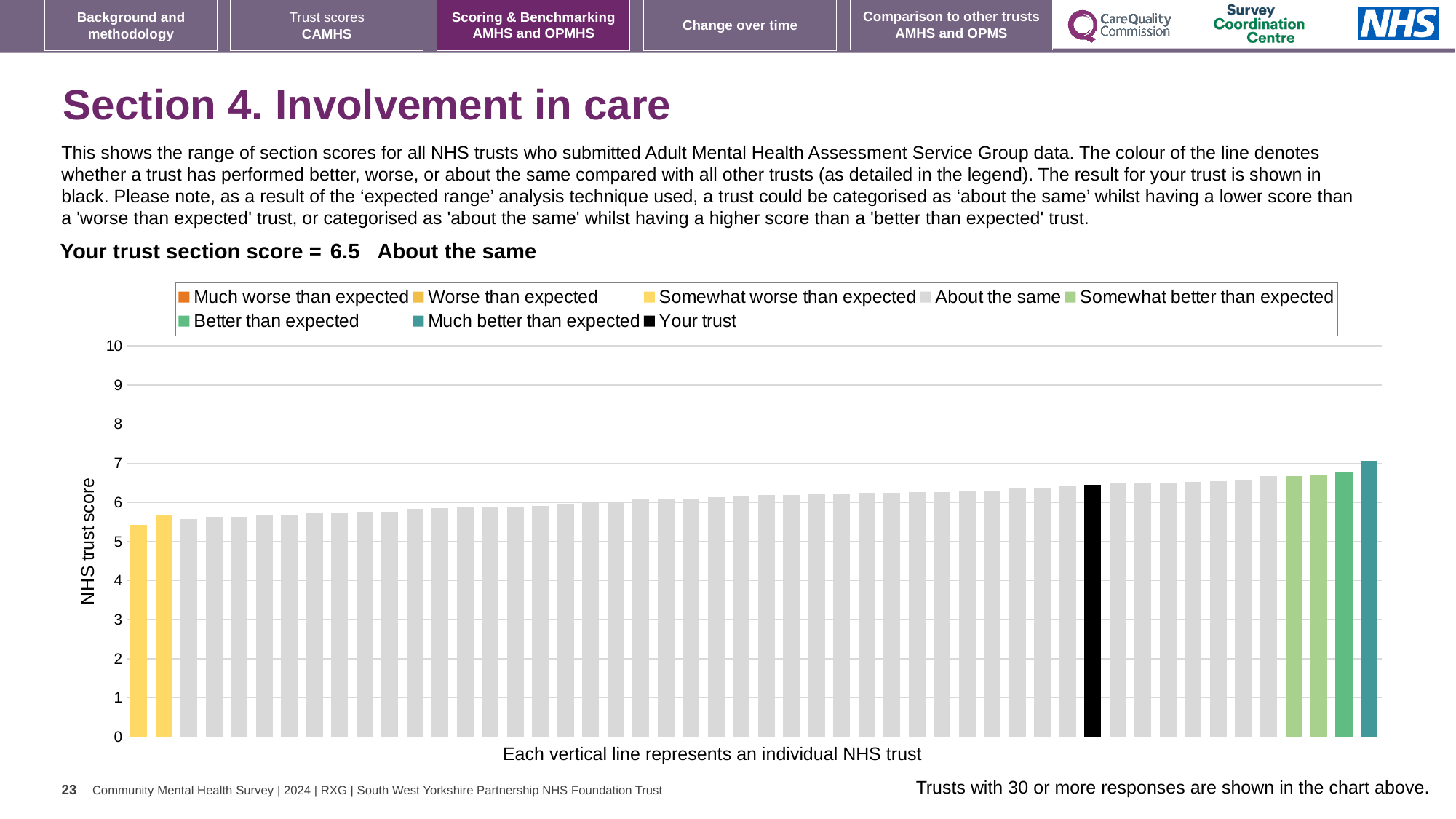
Which legend category does your trust fall into? About the same Is the lowest bar in the chart greater or less than 5? greater Which legend category does the highest bar in the chart belong to? Much better than expected What is the label on the vertical axis of the chart? NHS trust score What is the section score for your trust? 6.5 How many bars are coloured as 'Much better than expected'? 1 What kind of chart is shown on the slide? bar chart Is the value for your trust greater or less than 6? greater How many entries does the chart legend list? 8 How many bars are coloured as 'Worse than expected'? 0 Which legend category do the lowest bars in the chart belong to? Somewhat worse than expected Is the lowest bar in the chart greater or less than 6? less